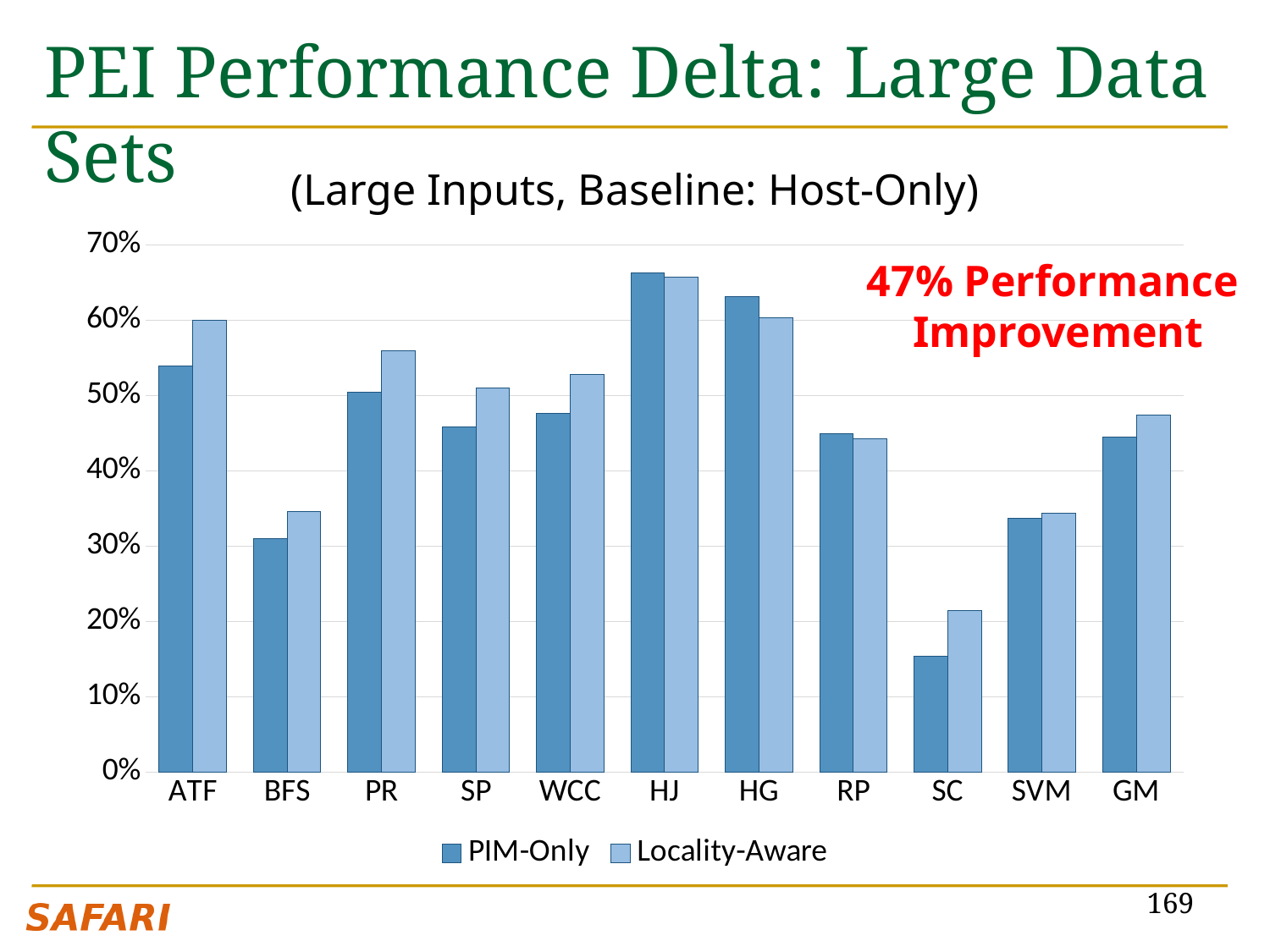
How many series does the legend list? 2 Is the PIM-Only value for ATF greater or less than 50%? greater Is the Locality-Aware value for BFS greater or less than 40%? less For HG, which series has the larger value, PIM-Only or Locality-Aware? PIM-Only For ATF, which series has the larger value, PIM-Only or Locality-Aware? Locality-Aware Which category has the lowest PIM-Only value? SC How many categories are shown along the x axis? 11 What kind of chart is shown on the slide? bar chart Which category has the highest PIM-Only value? HJ What are the two legend entries of the chart? PIM-Only and Locality-Aware Is the PIM-Only value for SC greater or less than 20%? less Which category has the lowest Locality-Aware value? SC